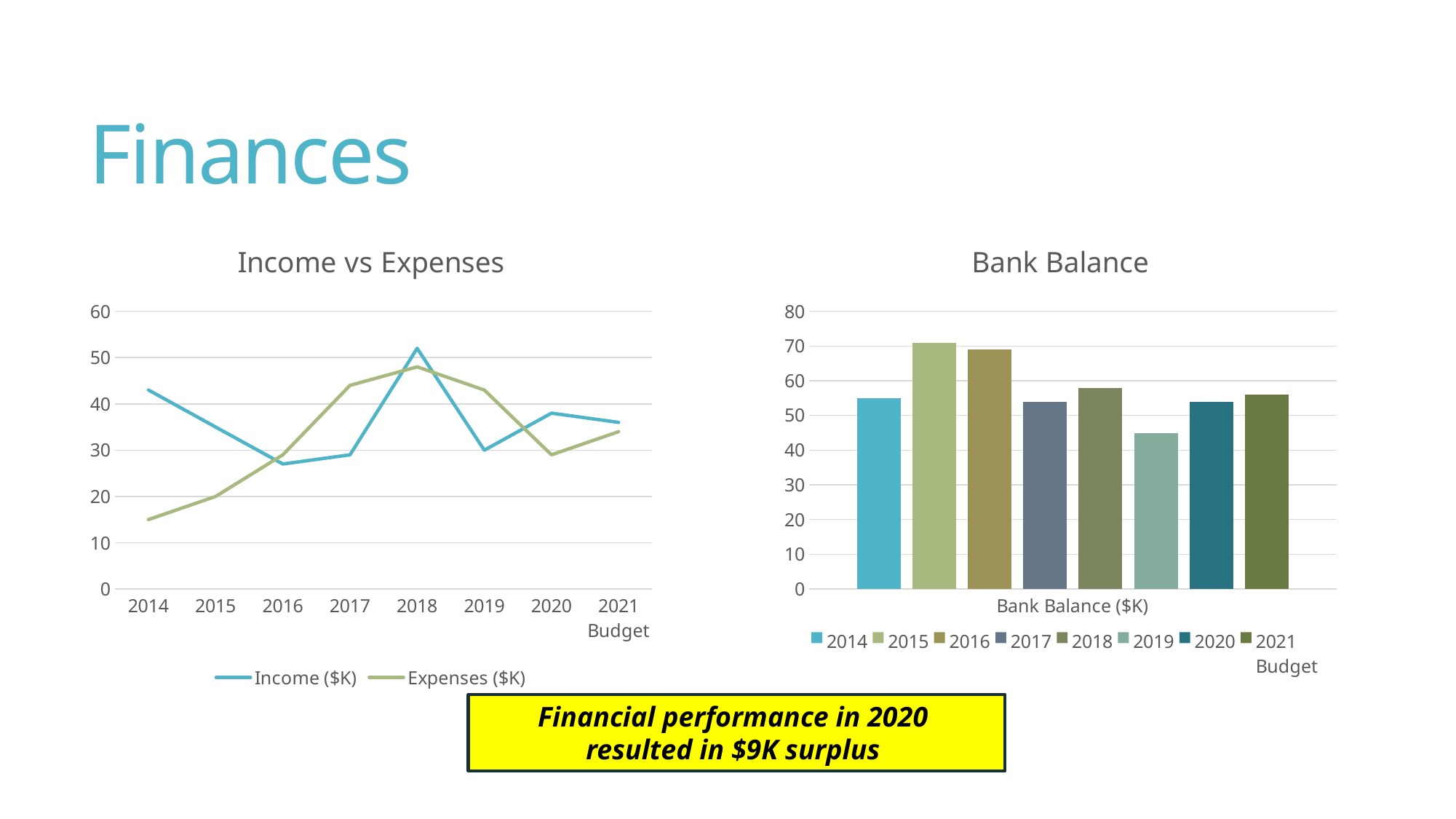
How many series does the legend of the Income vs Expenses chart list? 2 In the Income vs Expenses chart, do Expenses rise or fall from 2014 to 2018? rise What kind of chart is the Income vs Expenses chart? line chart In the Income vs Expenses chart, which is larger in 2017, Income or Expenses? Expenses In the Income vs Expenses chart, in which year is Income highest? 2018 What kind of chart is the Bank Balance chart? bar chart How many series does the legend of the Bank Balance chart list? 8 In the Income vs Expenses chart, is the Income value for 2018 greater or less than 50? greater In the Income vs Expenses chart, in which year are Expenses lowest? 2014 In the Bank Balance chart, is the value for 2019 greater or less than 50? less In the Bank Balance chart, which year has the lowest bank balance? 2019 How many years are shown on the x axis of the Income vs Expenses chart? 8